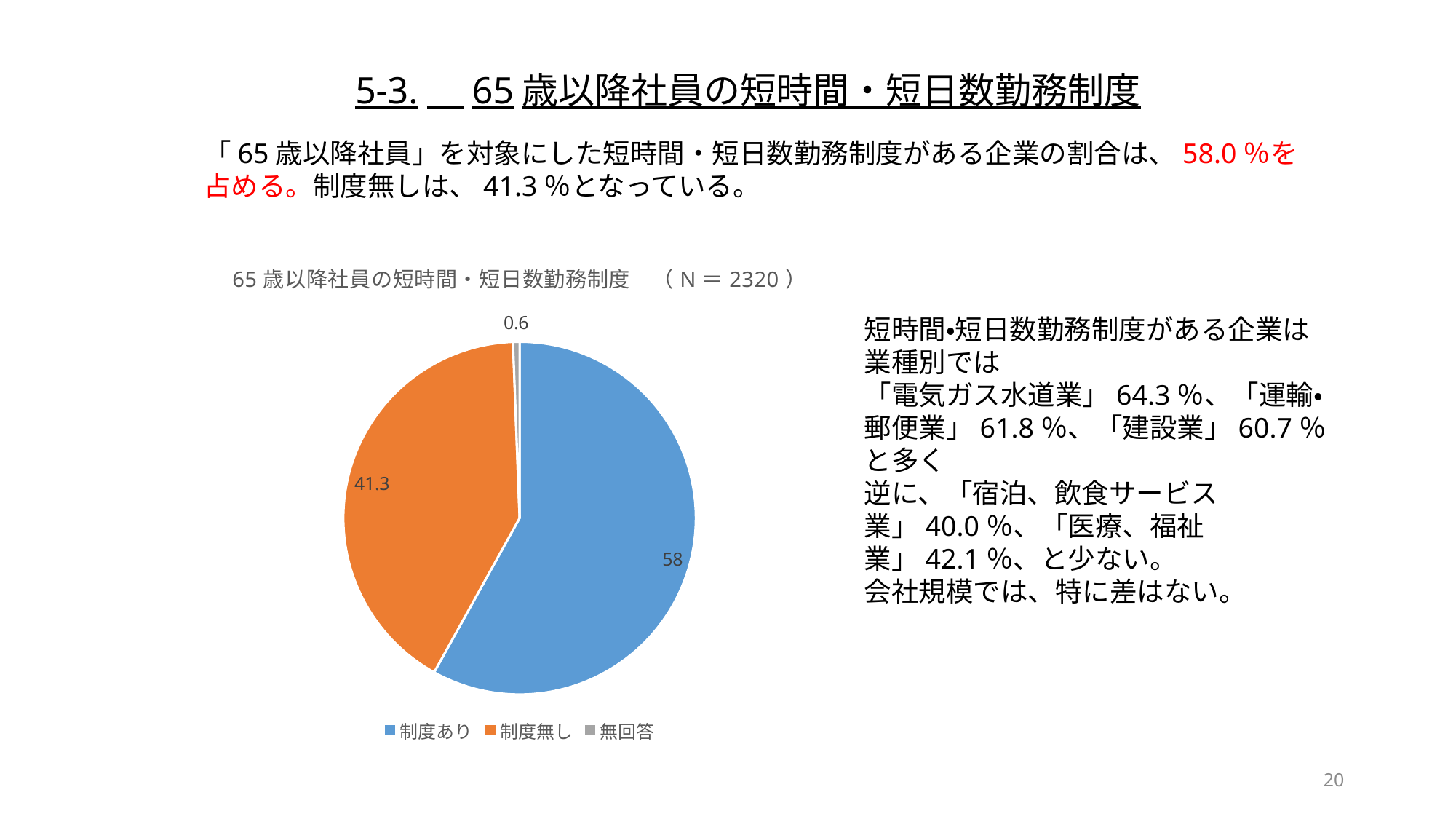
Which is larger, the value for 制度あり or the value for 制度無し? 制度あり What type of chart is shown on the slide? pie chart What is the value shown for 制度無し in the pie chart? 41.3 Which category has the smallest slice in the pie chart? 無回答 How many entries does the legend of the pie chart list? 3 What is the value shown for 制度あり in the pie chart? 58 What is the difference between the values for 制度あり and 制度無し? 16.7 Which category has the largest slice in the pie chart? 制度あり What is the difference between the values for 制度無し and 無回答? 40.7 What is the value shown for 無回答 in the pie chart? 0.6 How many categories are shown in the pie chart? 3 What is the N value shown in the chart title? 2320